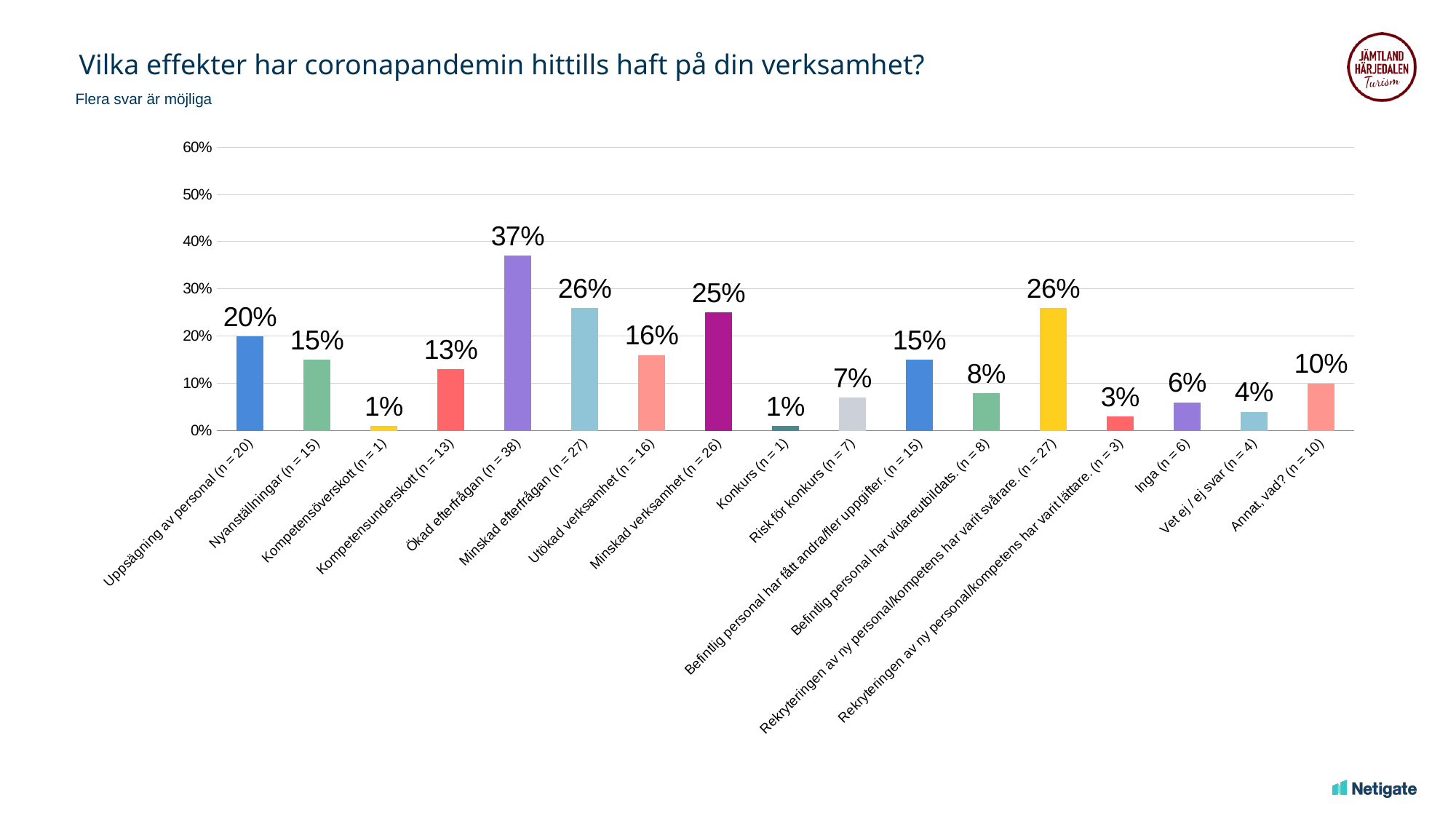
What percentage is shown for Ökad efterfrågan? 37% What kind of chart is this? Bar chart What is the difference between Ökad efterfrågan and Minskad efterfrågan? 11% What is the value for Uppsägning av personal? 20% Which is larger, Risk för konkurs or Annat, vad? Annat, vad? How many categories are shown on the x axis? 17 Which category has the highest value? Ökad efterfrågan What percentage is shown for Minskad verksamhet? 25% What is the title of the slide? Vilka effekter har coronapandemin hittills haft på din verksamhet? What is the value for Rekryteringen av ny personal/kompetens har varit lättare? 3% Which is larger, Utökad verksamhet or Minskad verksamhet? Minskad verksamhet What is the difference between Uppsägning av personal and Nyanställningar? 5%